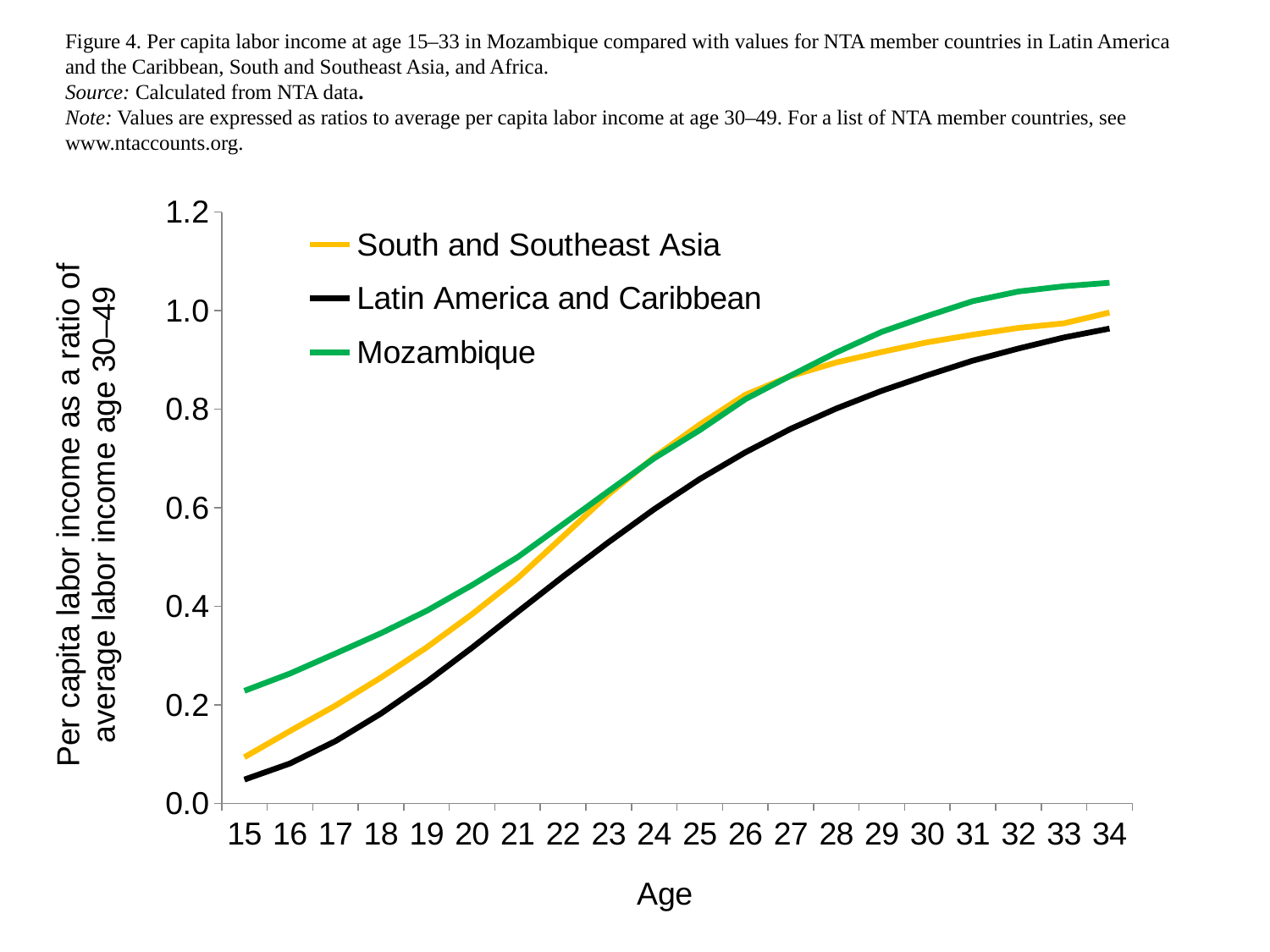
What is the label of the x axis? Age Which series has the lowest value at age 15? Latin America and Caribbean Is the value for Mozambique at age 34 greater or less than 1.0? greater Which series has the highest value at age 15? Mozambique How many ages are shown along the x axis? 20 What kind of chart is shown on the slide? Line chart Is the value for Latin America and Caribbean at age 34 greater or less than 1.0? less Is the value for Latin America and Caribbean at age 15 greater or less than 0.2? less How many series does the legend list? 3 Do the values for Mozambique rise or fall as age increases from 15 to 34? Rise At age 18, which is larger: the value for Mozambique or for Latin America and Caribbean? Mozambique